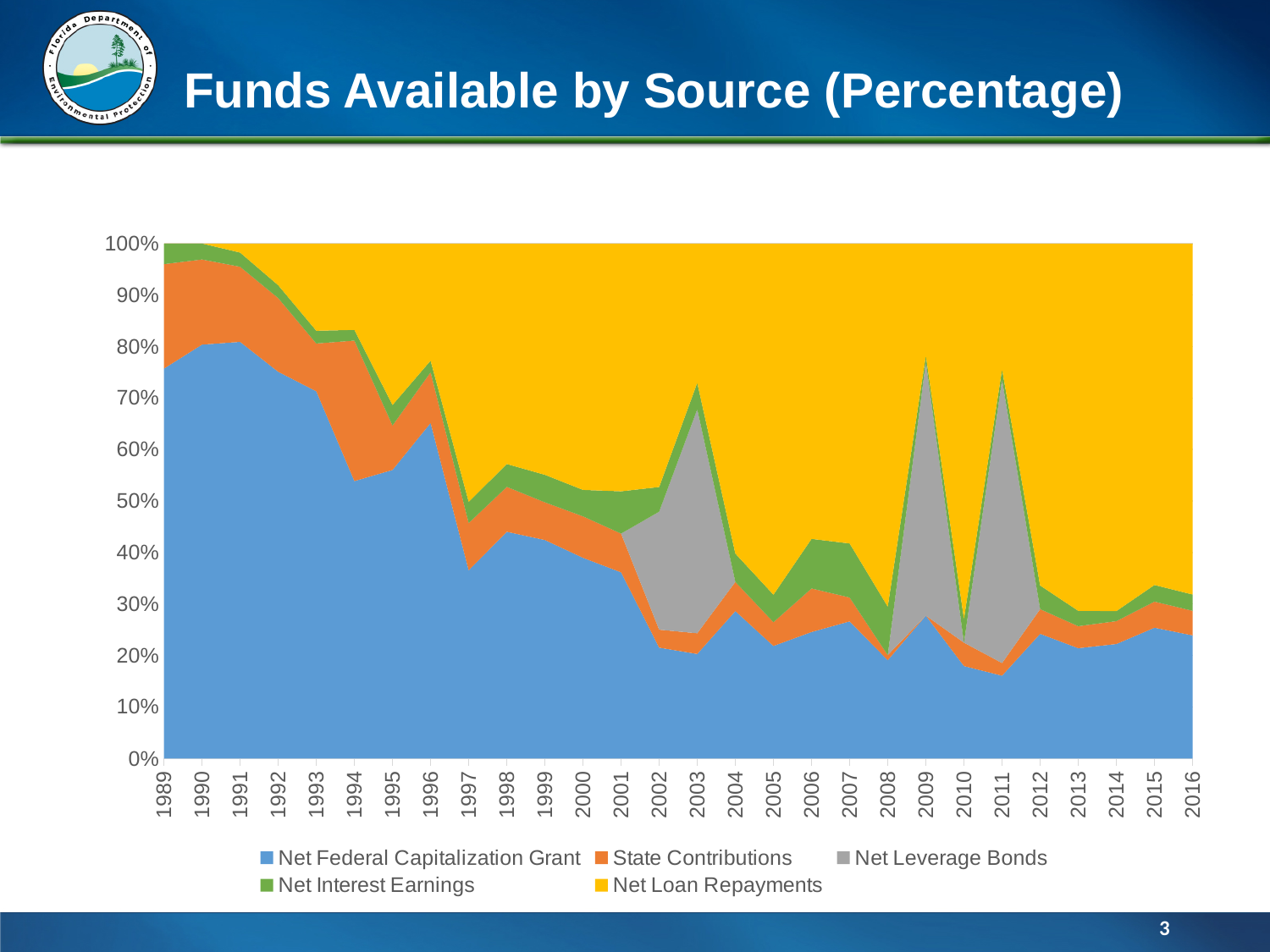
Which colour represents Net Loan Repayments in the chart? Yellow What is the title of the chart? Funds Available by Source (Percentage) Is the share for Net Loan Repayments in 2016 greater or less than 60%? greater Which is larger, the Net Federal Capitalization Grant share in 1989 or in 2016? 1989 Is the share for Net Loan Repayments in 1989 greater or less than 10%? less Is the share for Net Federal Capitalization Grant in 2016 greater or less than 30%? less How many years are plotted along the x axis? 28 What kind of chart is shown on the slide? Stacked area chart Does the share for Net Federal Capitalization Grant generally rise or fall from 1989 to 2016? Fall How many series does the legend list? 5 Does the share for Net Loan Repayments generally rise or fall from 1989 to 2016? Rise